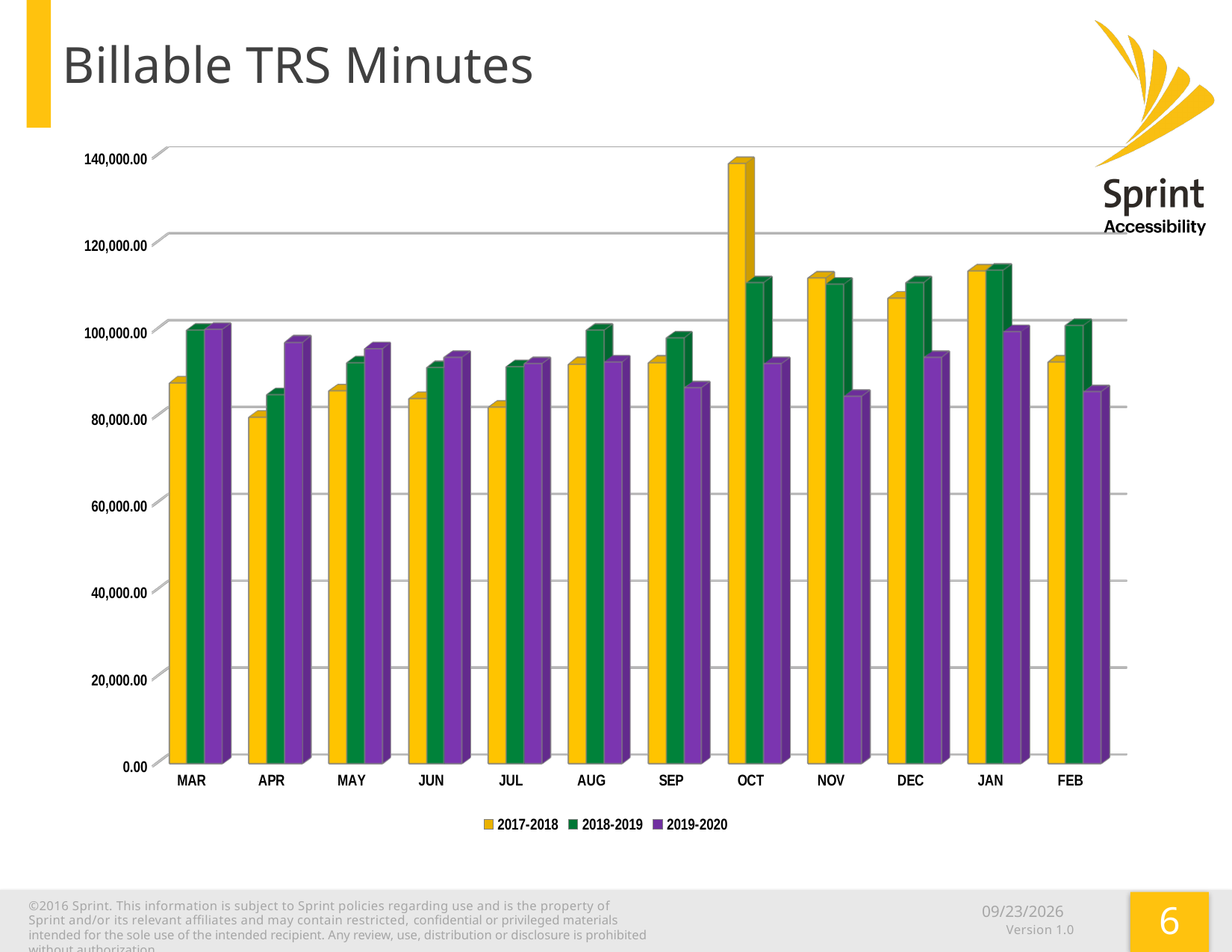
In APR, which series has the larger value, 2017-2018 or 2019-2020? 2019-2020 How many months are shown on the x axis? 12 How many series does the legend list? 3 Which month has the highest value for the 2017-2018 series? OCT What kind of chart is shown on the slide? bar chart In OCT, which series has the larger value, 2017-2018 or 2019-2020? 2017-2018 Is the 2019-2020 value for NOV greater or less than 100,000.00? less Which month has the lowest value for the 2018-2019 series? APR Which month has the lowest value for the 2017-2018 series? APR What is the title of the chart? Billable TRS Minutes Is the 2017-2018 value for OCT greater or less than 120,000.00? greater